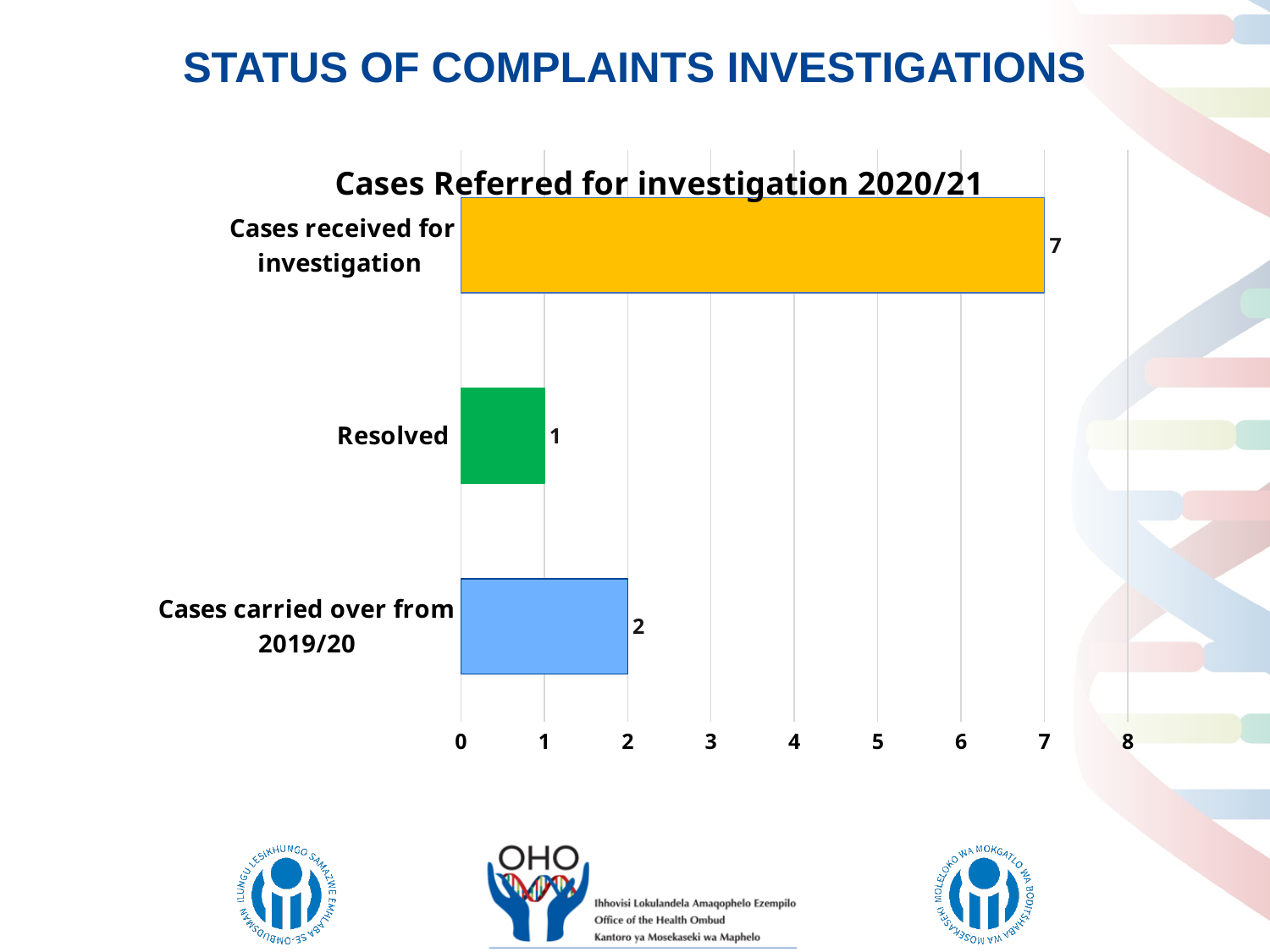
Which category has the highest value? Cases received for investigation What is the difference between Cases received for investigation and Cases carried over from 2019/20? 5 Which category has the lowest value? Resolved What is the value for Cases carried over from 2019/20? 2 What kind of chart is shown on the slide? bar chart What is the value for Cases received for investigation? 7 What is the value for Resolved? 1 Which is larger, Resolved or Cases carried over from 2019/20? Cases carried over from 2019/20 How many categories are shown in the chart? 3 What is the difference between Cases carried over from 2019/20 and Resolved? 1 Is the value for Cases received for investigation greater or less than 5? greater What is the title of the chart? Cases Referred for investigation 2020/21